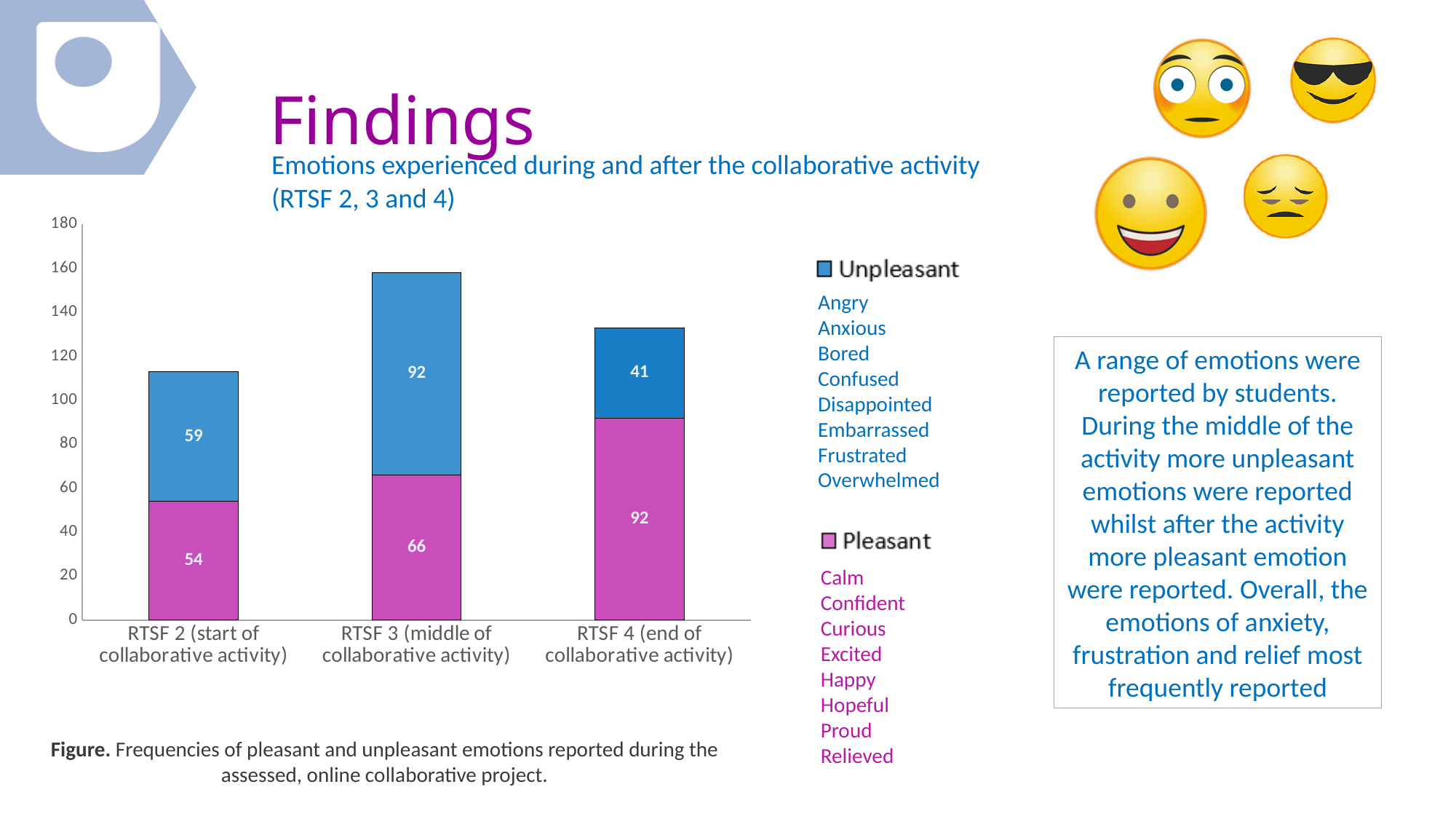
What is the difference between the Unpleasant values for RTSF 3 and RTSF 4? 51 What is the Unpleasant value for RTSF 3 (middle of collaborative activity)? 92 Which is larger for RTSF 4 (end of collaborative activity): the Pleasant value or the Unpleasant value? Pleasant What is the Pleasant value for RTSF 2 (start of collaborative activity)? 54 What is the Unpleasant value for RTSF 4 (end of collaborative activity)? 41 What is the total of the stacked bar for RTSF 2 (start of collaborative activity)? 113 Which category has the lowest Pleasant value? RTSF 2 (start of collaborative activity) How many series does the legend list? 2 What kind of chart is shown on the slide? Stacked bar chart What is the total of the stacked bar for RTSF 3 (middle of collaborative activity)? 158 Which category has the highest Unpleasant value? RTSF 3 (middle of collaborative activity) How many categories are shown on the x axis? 3